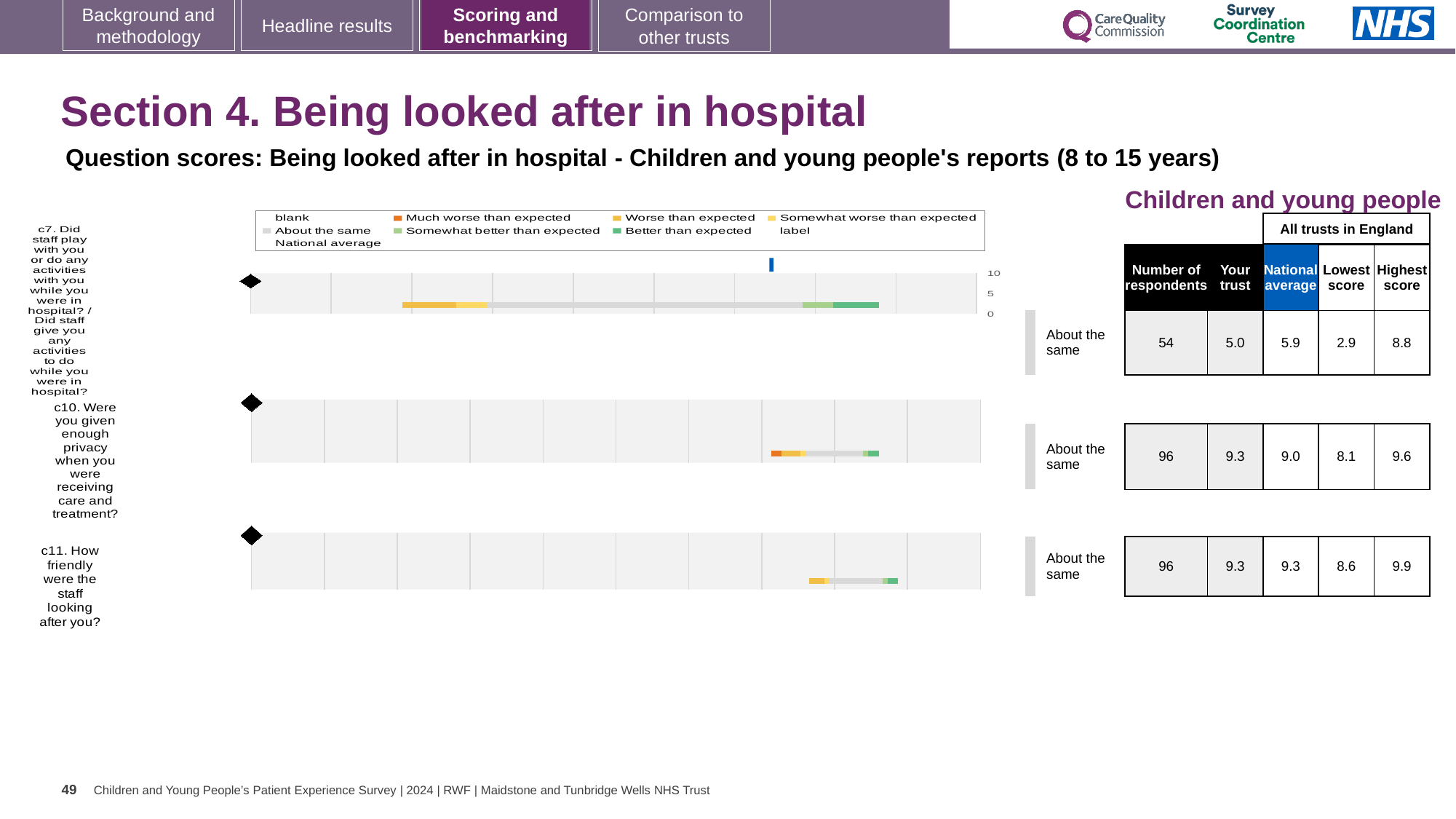
What is the 'Your trust' score for question c7 (Did staff play with you or do any activities with you while you were in hospital?)? 5.0 How many respondents answered question c7? 54 What is the difference between the highest score and the lowest score for question c7? 5.9 For question c10, which is larger: the 'Your trust' score or the national average? Your trust What is the highest score among all trusts in England for question c11 (How friendly were the staff looking after you?)? 9.9 What is the lowest score among all trusts in England for question c10? 8.1 What kind of chart is used to show the question scores on this slide? Bar chart What benchmark category is shown for question c11? About the same What is the difference between the national average and the 'Your trust' score for question c7? 0.9 Which question has the lowest 'Your trust' score on this slide? c7 What is the national average score for question c10 (Were you given enough privacy when you were receiving care and treatment?)? 9.0 How many questions are charted on this slide? 3